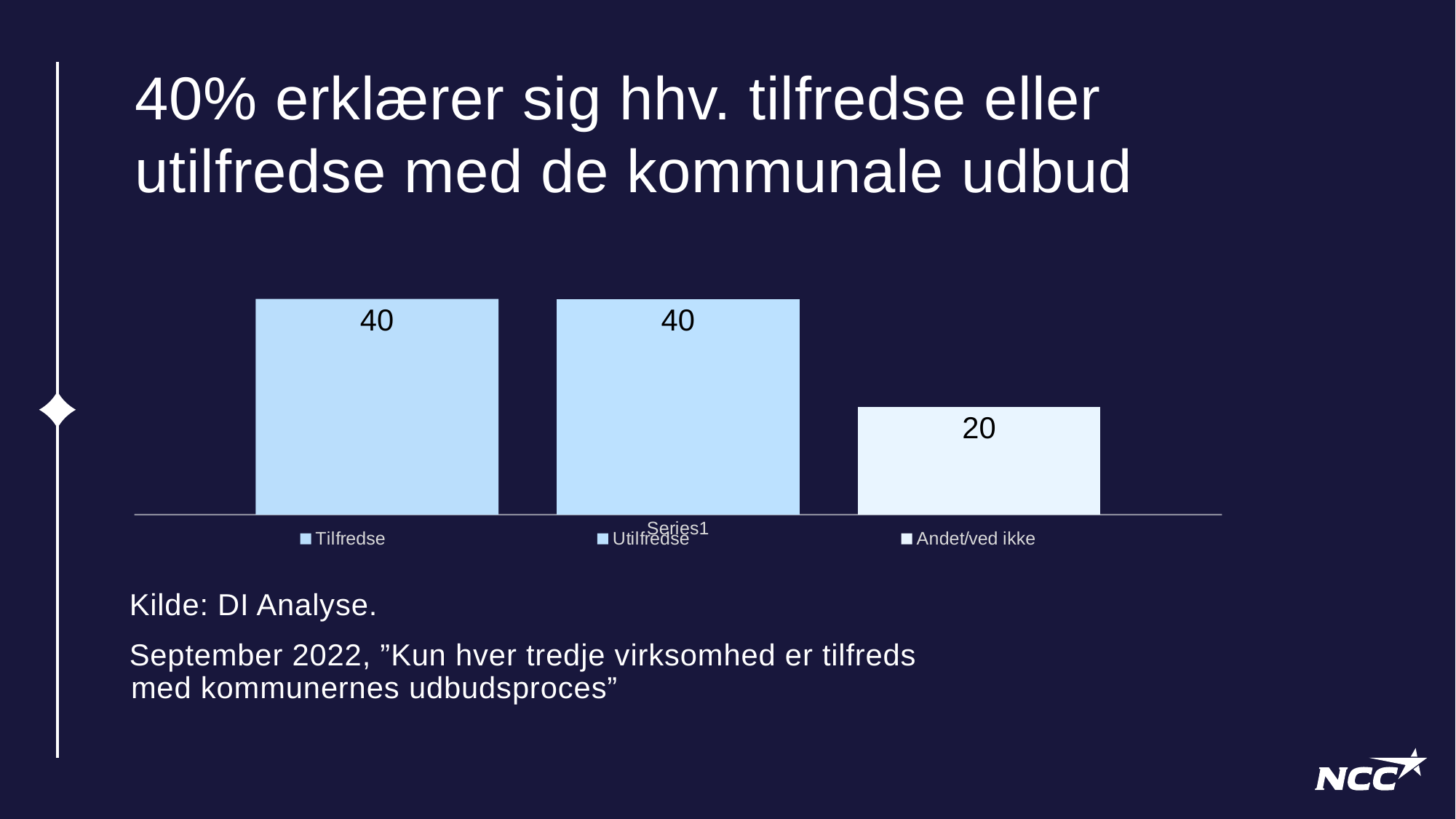
Which is larger, the value for Utilfredse or the value for Andet/ved ikke? Utilfredse Do Tilfredse and Utilfredse have the same value? Yes How many bars are shown in the chart? 3 What are the three legend entries of the chart? Tilfredse, Utilfredse, Andet/ved ikke What is the value of the Tilfredse bar? 40 What is the difference between the Tilfredse value and the Andet/ved ikke value? 20 What source is cited below the chart? DI Analyse Which category has the lowest value? Andet/ved ikke What is the value of the Utilfredse bar? 40 What is the value of the Andet/ved ikke bar? 20 How many entries does the legend list? 3 What kind of chart is shown on the slide? Bar chart